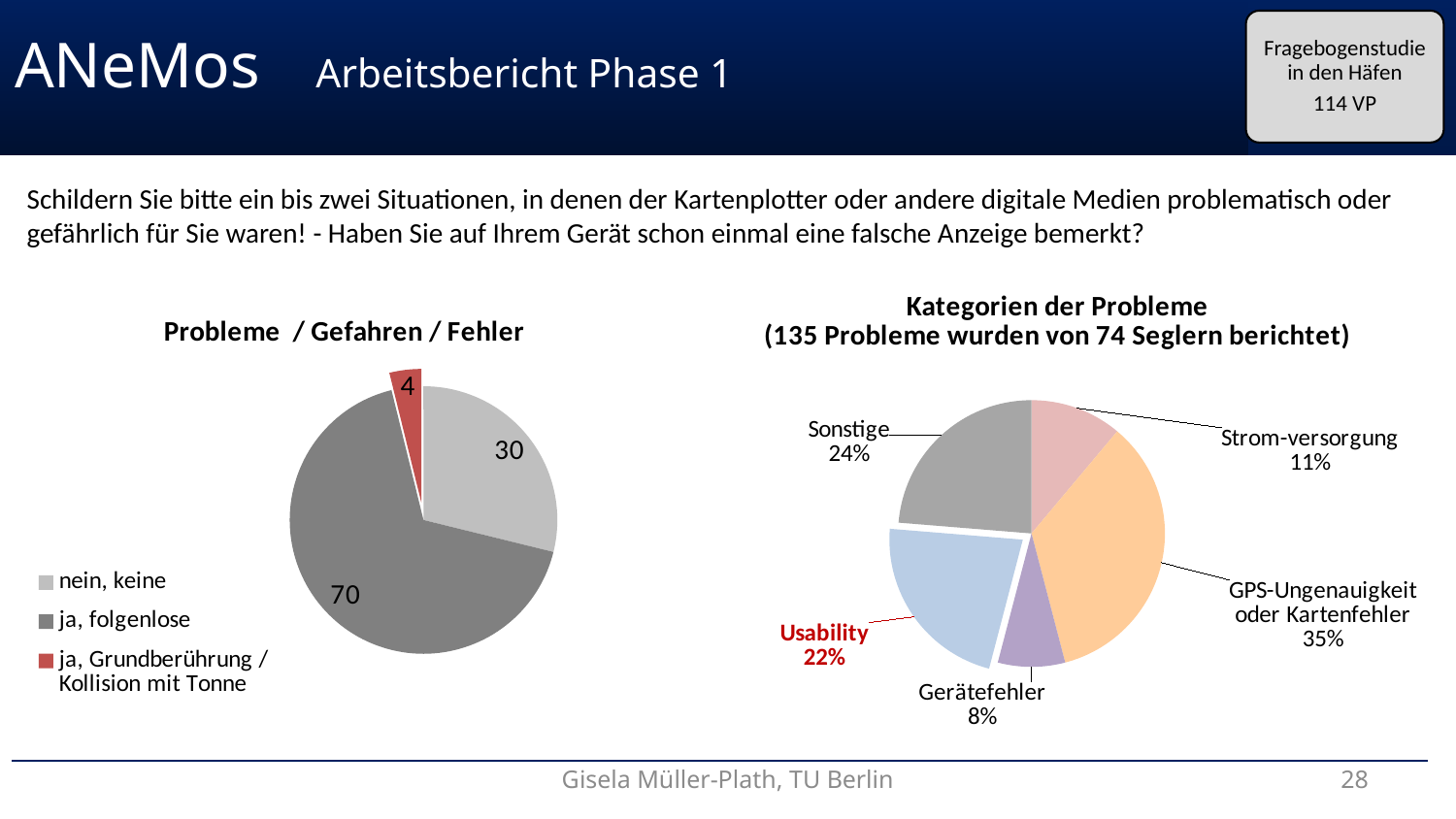
In the chart titled "Probleme / Gefahren / Fehler", how many categories does the legend list? 3 In the chart titled "Probleme / Gefahren / Fehler", what is the value for "ja, folgenlose"? 70 In the chart titled "Kategorien der Probleme", which category has the smallest share? Gerätefehler In the chart titled "Kategorien der Probleme", how many categories are shown? 5 In the chart titled "Probleme / Gefahren / Fehler", what is the value for "nein, keine"? 30 In the chart titled "Probleme / Gefahren / Fehler", what is the difference between the values for "ja, folgenlose" and "nein, keine"? 40 In the chart titled "Kategorien der Probleme", what share is shown for "Usability"? 22% What kind of chart is the chart titled "Kategorien der Probleme"? pie chart In the chart titled "Probleme / Gefahren / Fehler", which category has the largest slice? ja, folgenlose In the chart titled "Probleme / Gefahren / Fehler", what is the value for "ja, Grundberührung / Kollision mit Tonne"? 4 In the chart titled "Kategorien der Probleme", what share is shown for "GPS-Ungenauigkeit oder Kartenfehler"? 35% In the chart titled "Kategorien der Probleme", which is larger: "Sonstige" or "Strom-versorgung"? Sonstige